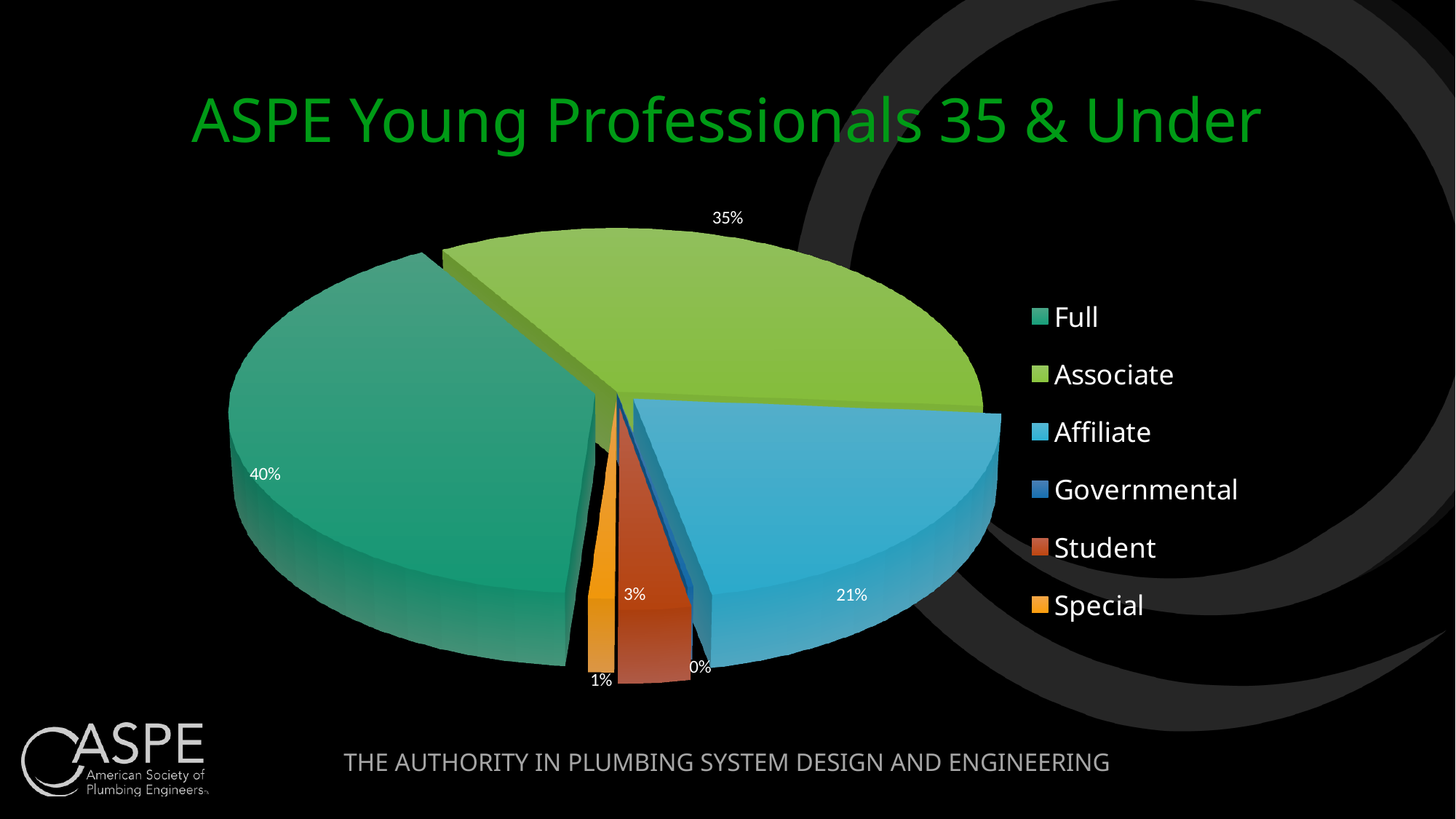
Which is larger, the Affiliate share or the Student share? Affiliate What share of the pie does the Governmental category have? 0% Which category has the smallest share of the pie? Governmental What is the difference between the Full share and the Associate share? 5% Which category has the largest share of the pie? Full What share of the pie does the Student category have? 3% What share of the pie does the Special category have? 1% What kind of chart is shown on the slide? pie chart How many categories does the legend list? 6